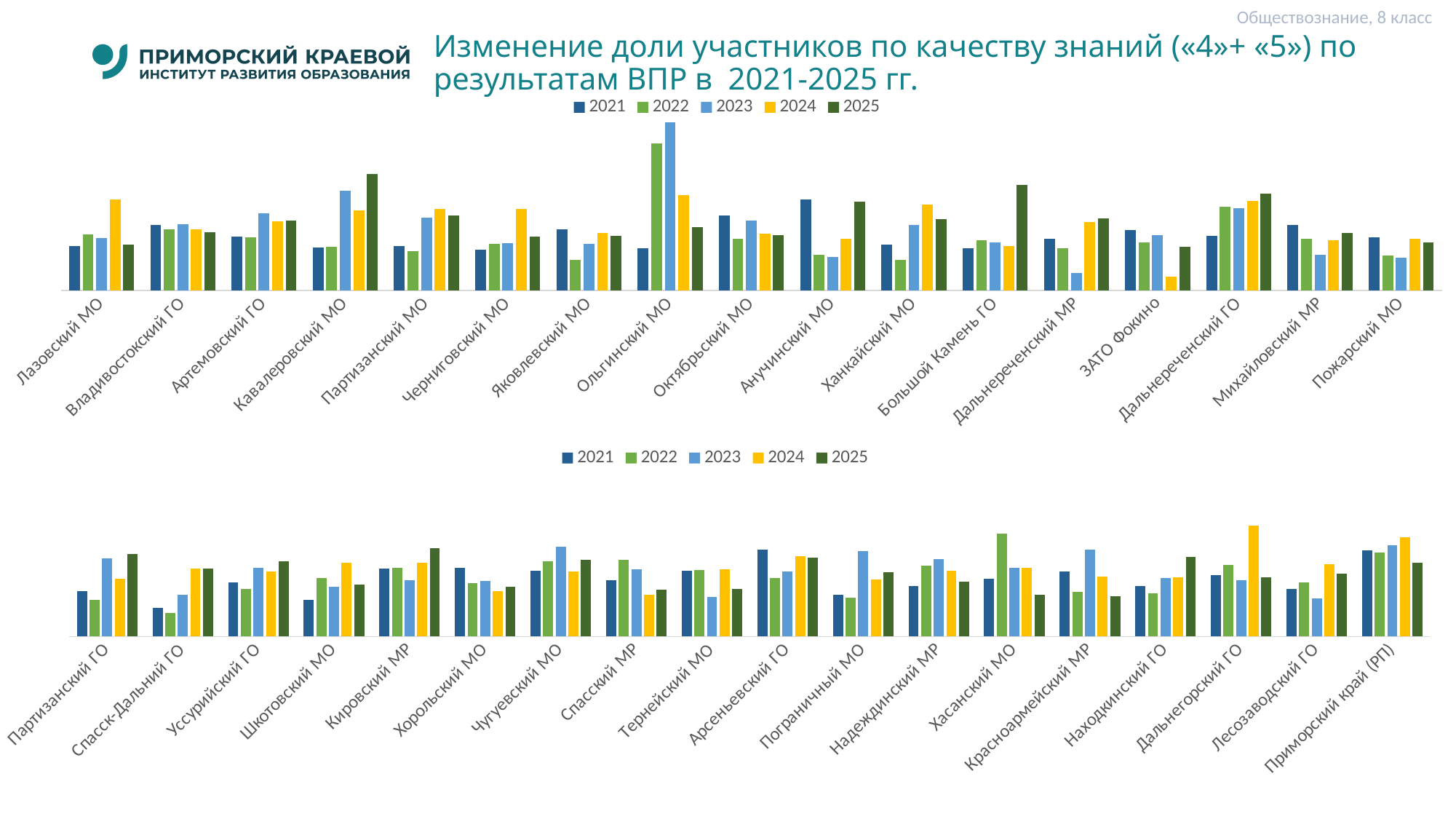
How many categories are shown on the x axis of the bottom chart? 18 Which years are listed in the legend of the bottom chart? 2021, 2022, 2023, 2024, 2025 In the bottom chart, which is larger for Спасск-Дальний ГО: the 2022 value or the 2024 value? 2024 In the bottom chart, which year has the highest value for Хасанский МО? 2022 In the top chart, which year has the lowest value for ЗАТО Фокино? 2024 In the top chart, which is larger for Кавалеровский МО: the 2021 value or the 2025 value? 2025 In the top chart, which category has the tallest bar overall? Ольгинский МО In the bottom chart, which category has the tallest bar overall? Дальнегорский ГО What kind of chart is the top chart on the slide? bar chart How many categories are shown on the x axis of the top chart? 17 How many series does the legend of the top chart list? 5